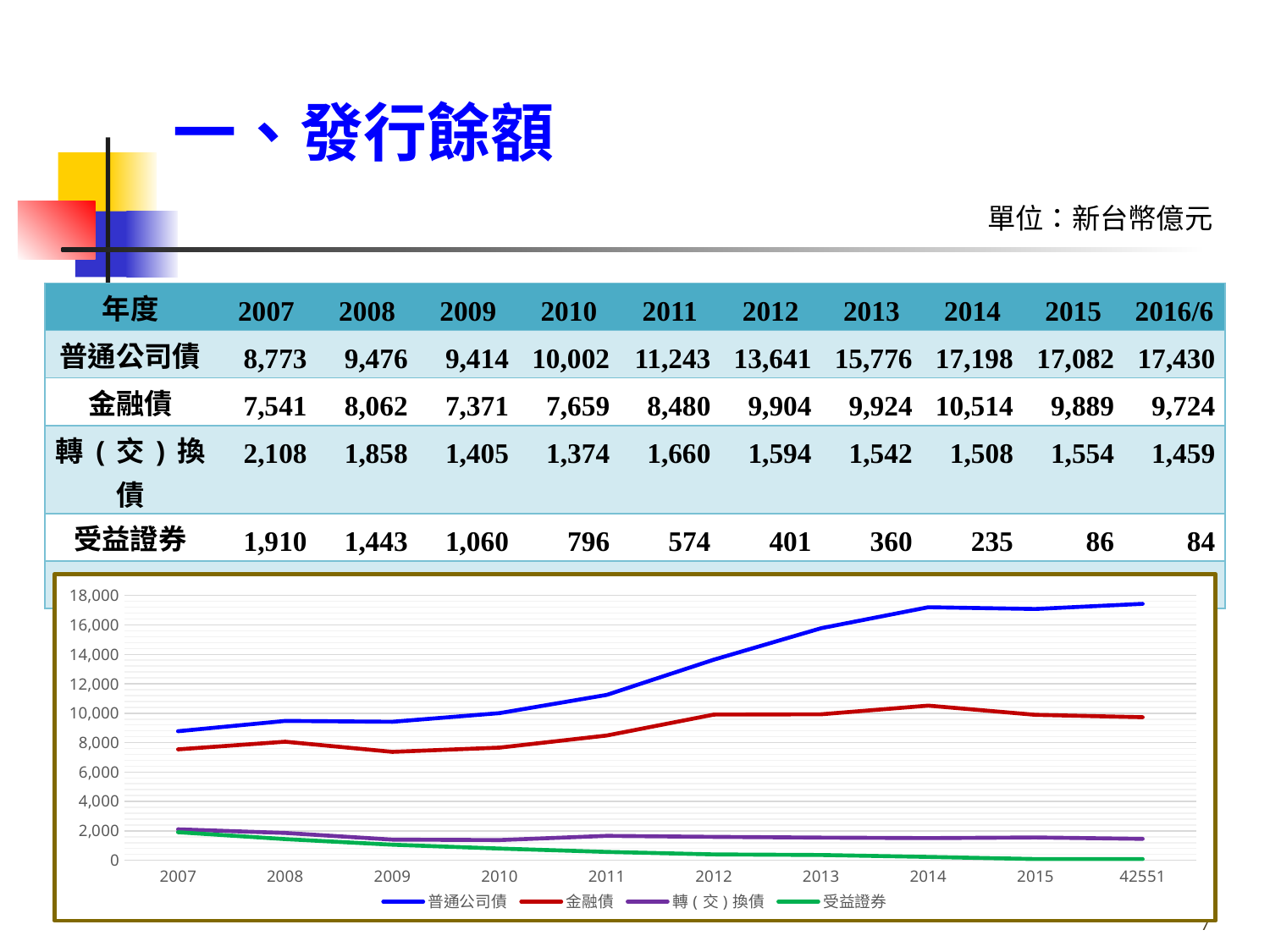
What colour is the 金融債 line in the chart? red Is the value for 金融債 in 2009 greater or less than 8,000? less How many points along the x axis does each line in the chart have? 10 What is the value of 普通公司債 in 2012 as printed in the table above the chart? 13,641 How many series does the chart legend list? 4 What kind of chart is shown on the slide? line chart Does the 受益證券 line rise or fall from 2007 to the last point? fall Is the value for 普通公司債 in 2013 greater or less than 14,000? greater Which series has the lowest value in 2015? 受益證券 Which series has the highest value in 2014? 普通公司債 Does the 普通公司債 line generally rise or fall from 2007 to the last point? rise Which is larger in 2011, 金融債 or 轉（交）換債? 金融債